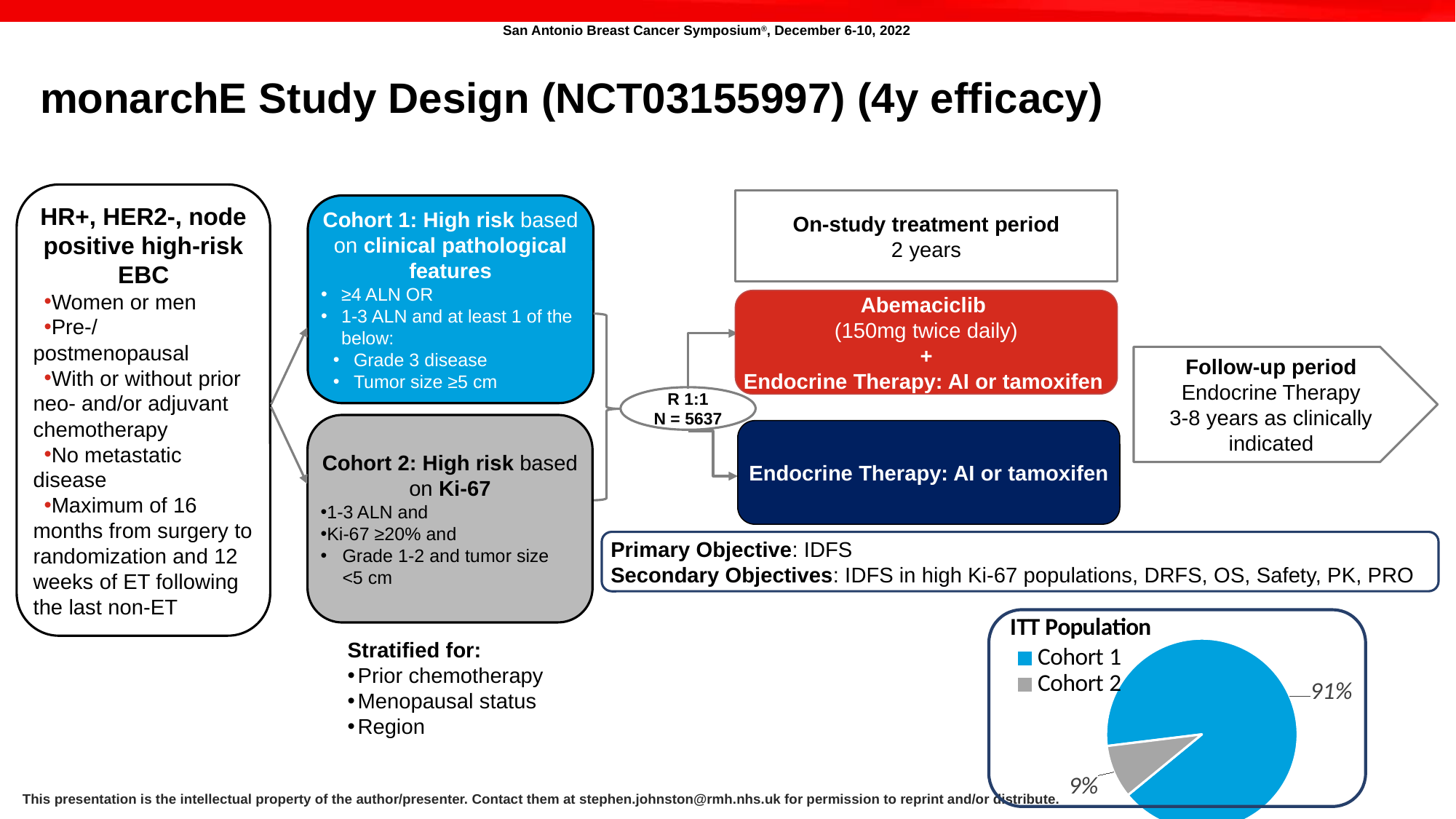
Which cohort has the largest slice in the ITT Population pie chart? Cohort 1 In the ITT Population pie chart, which is larger: Cohort 1 or Cohort 2? Cohort 1 Which cohort has the smallest slice in the ITT Population pie chart? Cohort 2 What colour is the Cohort 2 slice in the ITT Population pie chart? grey What share of the ITT Population pie does Cohort 2 represent? 9% What share of the ITT Population pie does Cohort 1 represent? 91% How many entries does the legend of the ITT Population pie chart list? 2 What is the title of the pie chart? ITT Population What kind of chart is shown in the ITT Population box? pie chart In the ITT Population pie chart, what is the difference in percentage points between Cohort 1 and Cohort 2? 82 How many slices does the ITT Population pie chart have? 2